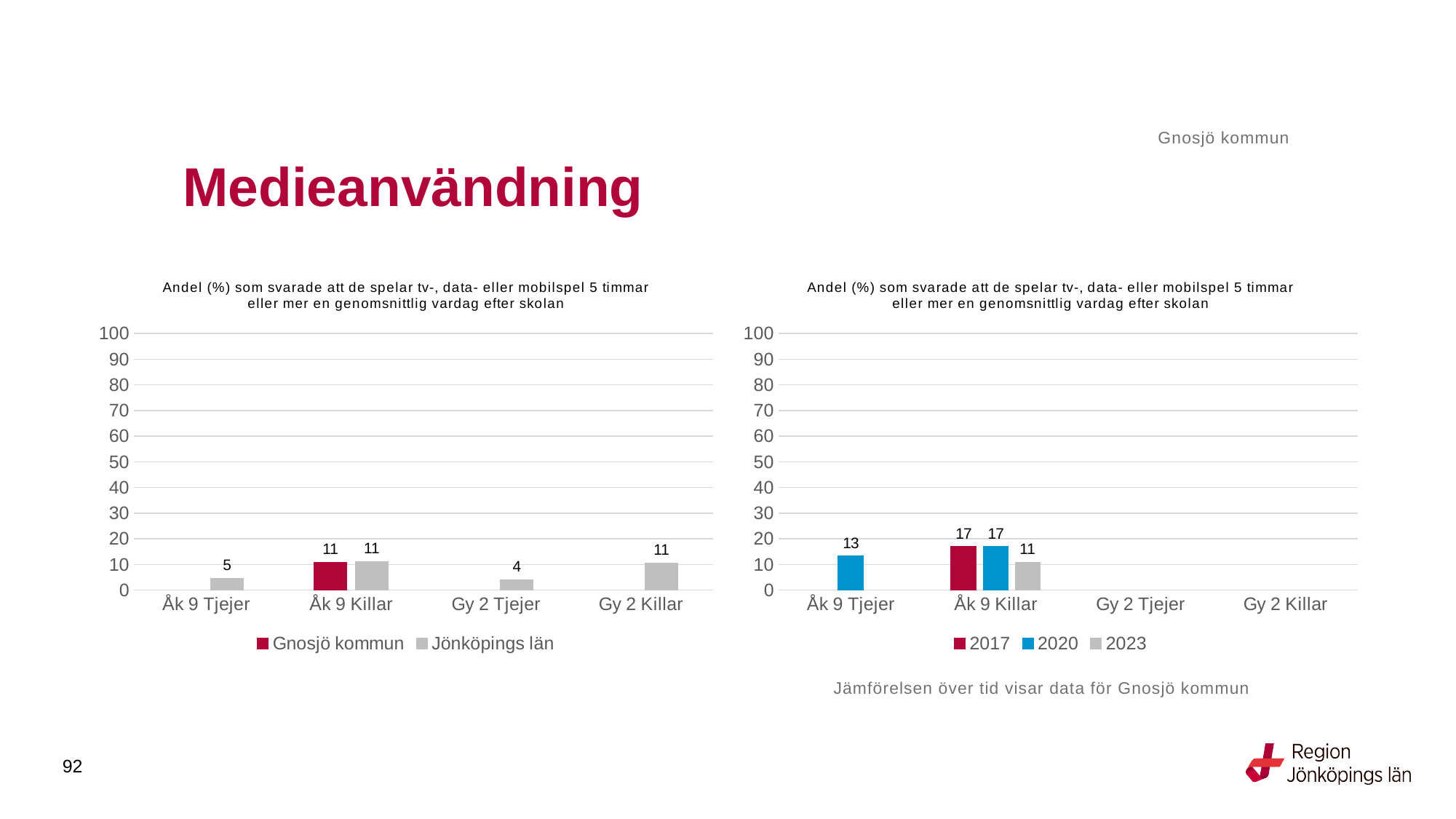
In the left chart, what is the value for Jönköpings län for Gy 2 Tjejer? 4 In the right chart, how many series does the legend list? 3 In the left chart, what is the value for Jönköpings län for Åk 9 Tjejer? 5 In the right chart, what is the difference between the 2017 and 2023 values for Åk 9 Killar? 6 In the right chart, what is the value for 2023 for Åk 9 Killar? 11 In the left chart, which category has the lowest value for Jönköpings län? Gy 2 Tjejer In the right chart, which is larger for Åk 9 Killar: the 2020 value or the 2023 value? 2020 In the left chart, what is the value for Gnosjö kommun for Åk 9 Killar? 11 What kind of chart is the right chart? Bar chart In the left chart, what is the difference between the Jönköpings län values for Åk 9 Killar and Åk 9 Tjejer? 6 In the right chart, what is the value for 2020 for Åk 9 Tjejer? 13 In the left chart, how many series does the legend list? 2